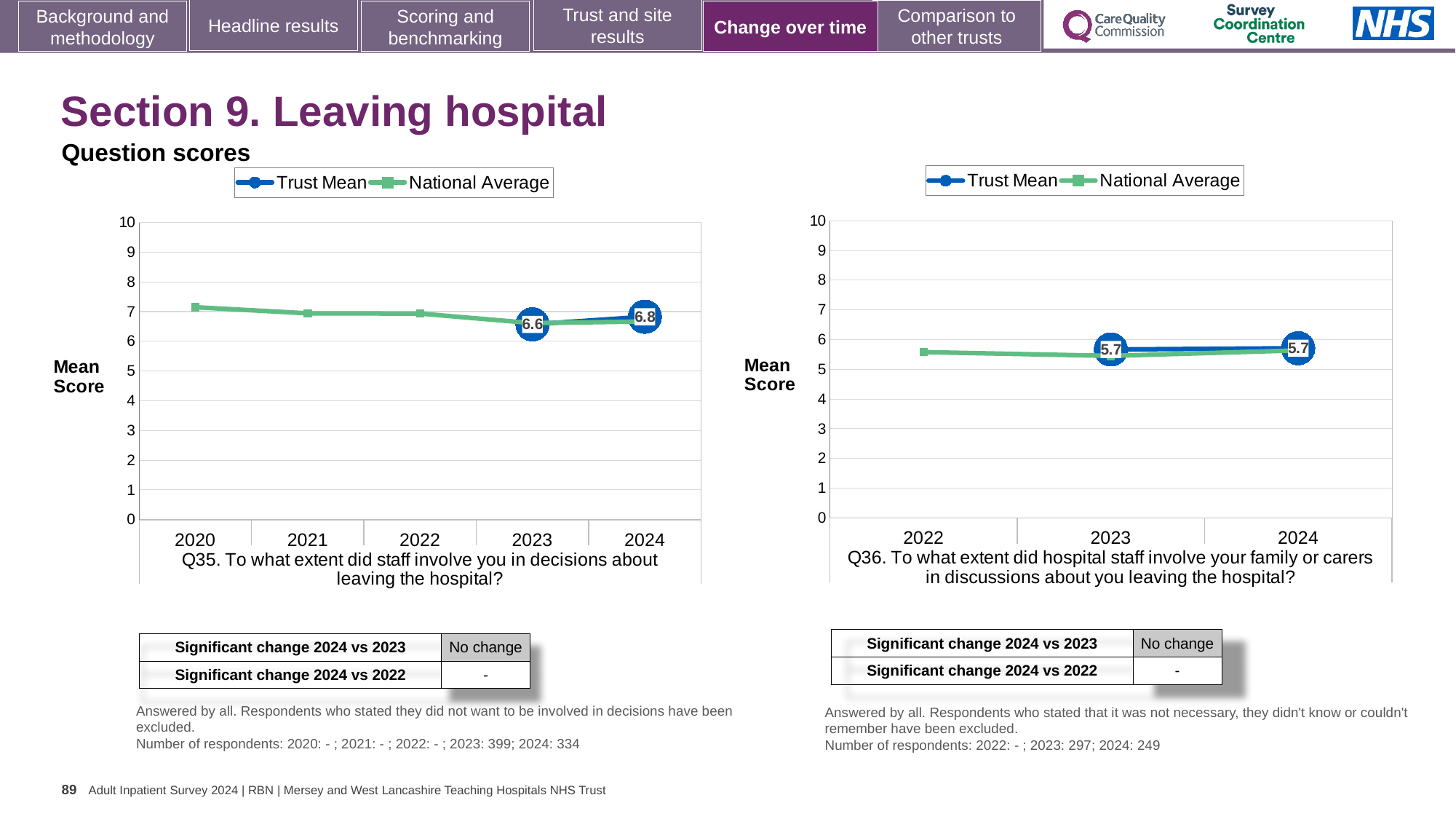
In the right chart (Q36), is the National Average for 2022 greater or less than 6? less How many years are shown on the x axis of the left chart (Q35)? 5 In the left chart (Q35), which year has the higher Trust Mean, 2023 or 2024? 2024 In the left chart (Q35), is the National Average for 2020 greater or less than 6? greater In the left chart (Q35), by how much did the Trust Mean change from 2023 to 2024? 0.2 In the left chart (Q35), what is the Trust Mean score for 2024? 6.8 In the right chart (Q36), what is the Trust Mean score for 2024? 5.7 How many years are shown on the x axis of the right chart (Q36)? 3 What type of chart is used for Q36 on the right? Line chart In the left chart (Q35), what is the Trust Mean score for 2023? 6.6 How many series does the legend of the left chart (Q35) list? 2 In the right chart (Q36), did the Trust Mean rise, fall or stay the same between 2023 and 2024? Stayed the same